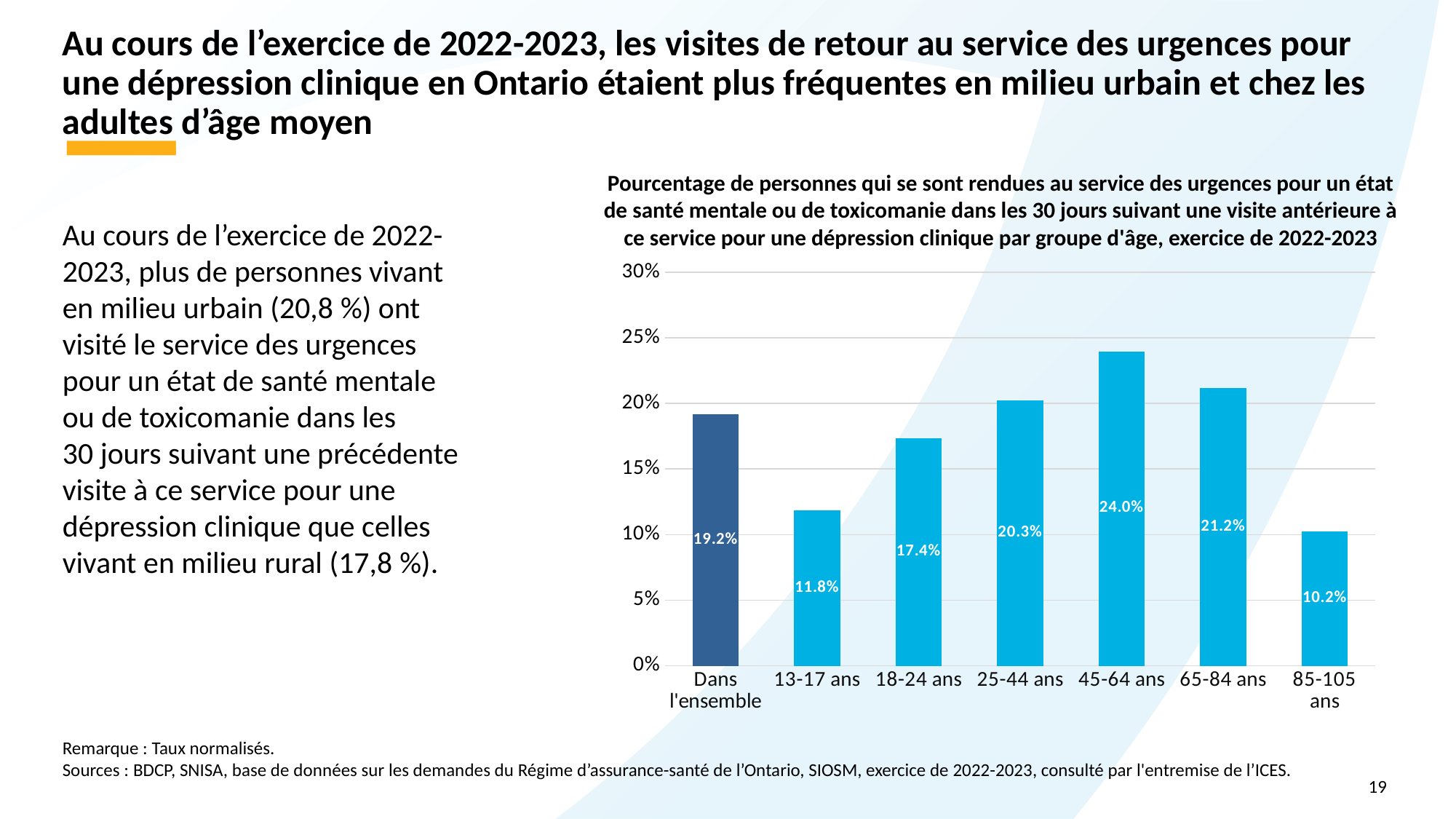
What kind of chart is shown on the slide? Bar chart Which bar is shown in a darker blue colour than the others? Dans l'ensemble What is the value for the 13-17 ans age group? 11.8% Which category has the lowest value? 85-105 ans What is the difference between the values for 45-64 ans and 13-17 ans? 12.2% Which is larger, the value for 25-44 ans or the value for 65-84 ans? 65-84 ans How many bars are shown in the chart? 7 Do the values rise or fall from 13-17 ans to 45-64 ans? Rise Is the value for 18-24 ans greater or less than 15%? greater What is the value for the 45-64 ans age group? 24.0% What is the value for the 'Dans l'ensemble' bar? 19.2% Which age group has the highest value? 45-64 ans